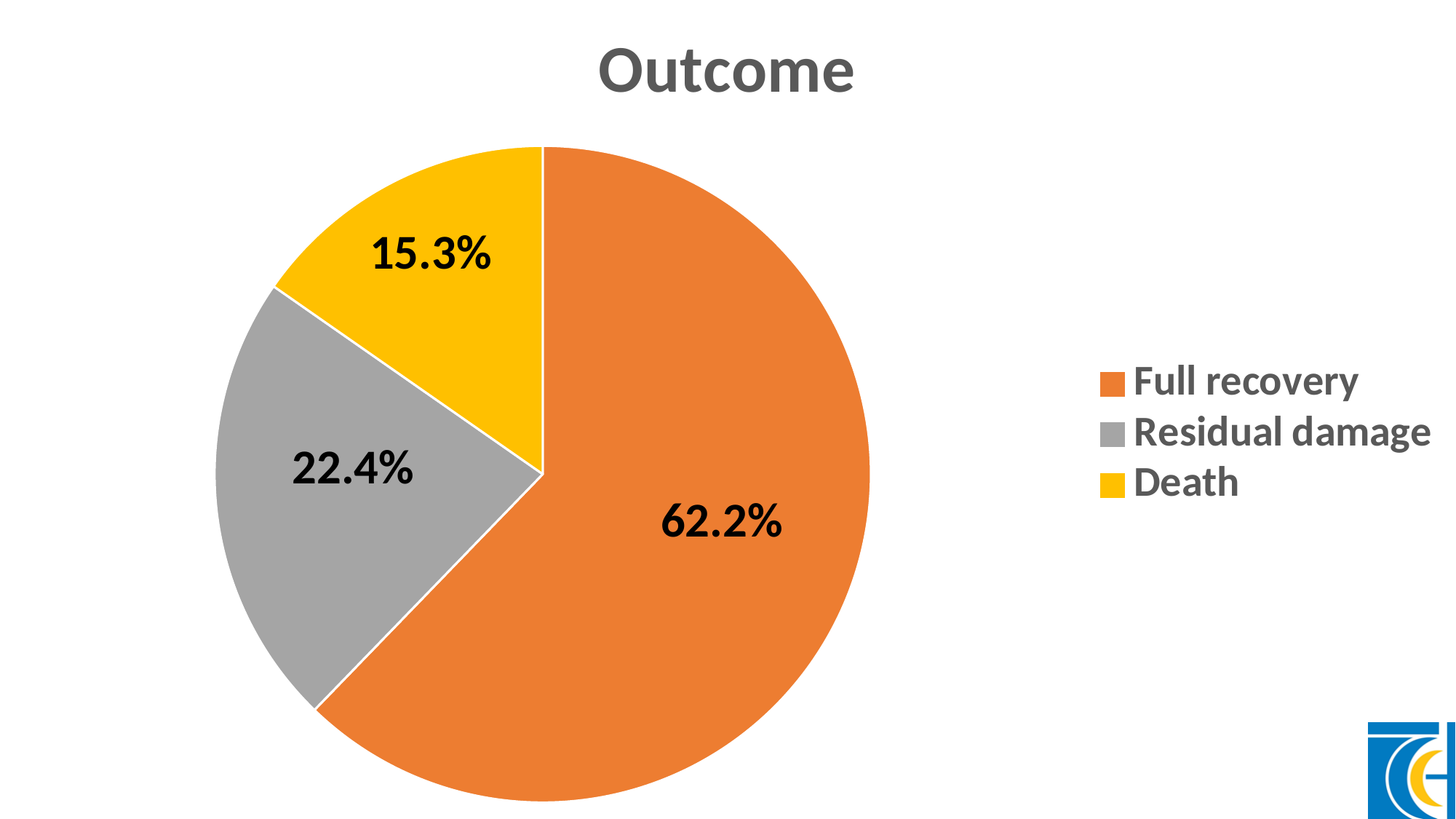
Which colour represents Death in the pie chart? yellow What share of the pie is Full recovery? 62.2% What is the title of the chart? Outcome Which outcome has the largest slice of the pie? Full recovery Which outcome has the smallest slice of the pie? Death What kind of chart is shown on the slide? pie chart What is the difference in percentage points between Residual damage and Death? 7.1 What share of the pie is Death? 15.3% What is the difference in percentage points between Full recovery and Residual damage? 39.8 What share of the pie is Residual damage? 22.4% Which is larger, the share for Residual damage or the share for Death? Residual damage How many slices does the pie chart have? 3